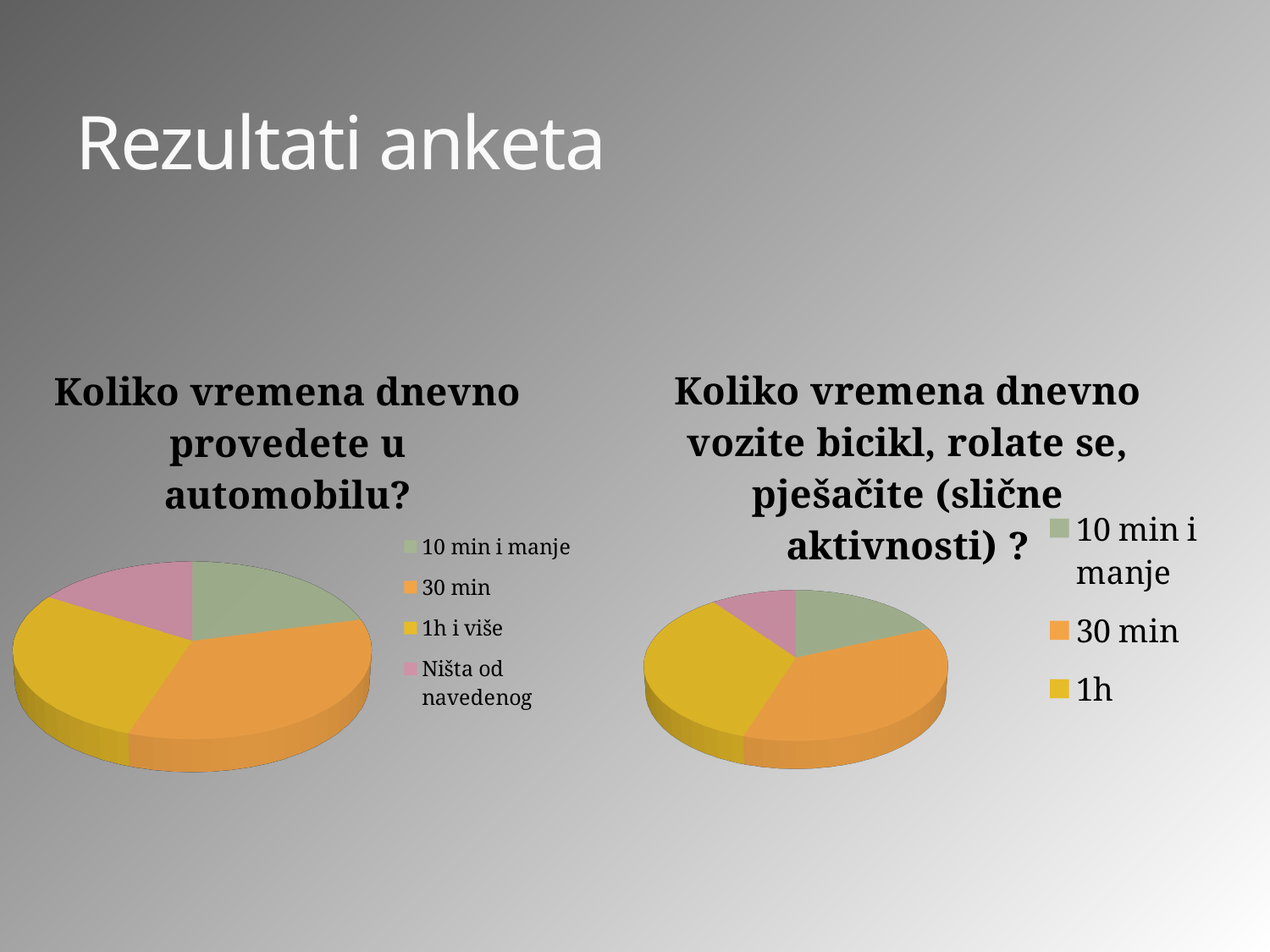
In the chart titled "Koliko vremena dnevno provedete u automobilu?", what colour is the slice for "Ništa od navedenog"? pink In the chart titled "Koliko vremena dnevno provedete u automobilu?", which slice is larger: "1h i više" or "10 min i manje"? 1h i više How many categories does the legend of the chart titled "Koliko vremena dnevno provedete u automobilu?" list? 4 What is the title of the chart on the left of the slide? Koliko vremena dnevno provedete u automobilu? In the chart on the right ("Koliko vremena dnevno vozite bicikl, rolate se, pješačite"), which slice is larger: "1h" or "10 min i manje"? 1h In the chart titled "Koliko vremena dnevno provedete u automobilu?", which category has the smallest slice? Ništa od navedenog In the chart titled "Koliko vremena dnevno provedete u automobilu?", which slice is larger: "30 min" or "Ništa od navedenog"? 30 min How many entries does the legend of the chart on the right of the slide list? 3 In the chart on the right ("Koliko vremena dnevno vozite bicikl, rolate se, pješačite"), which legend category has the largest slice? 30 min What kind of chart is the chart on the right of the slide? pie chart What kind of chart is the chart titled "Koliko vremena dnevno provedete u automobilu?"? pie chart In the chart titled "Koliko vremena dnevno provedete u automobilu?", which category has the largest slice? 30 min